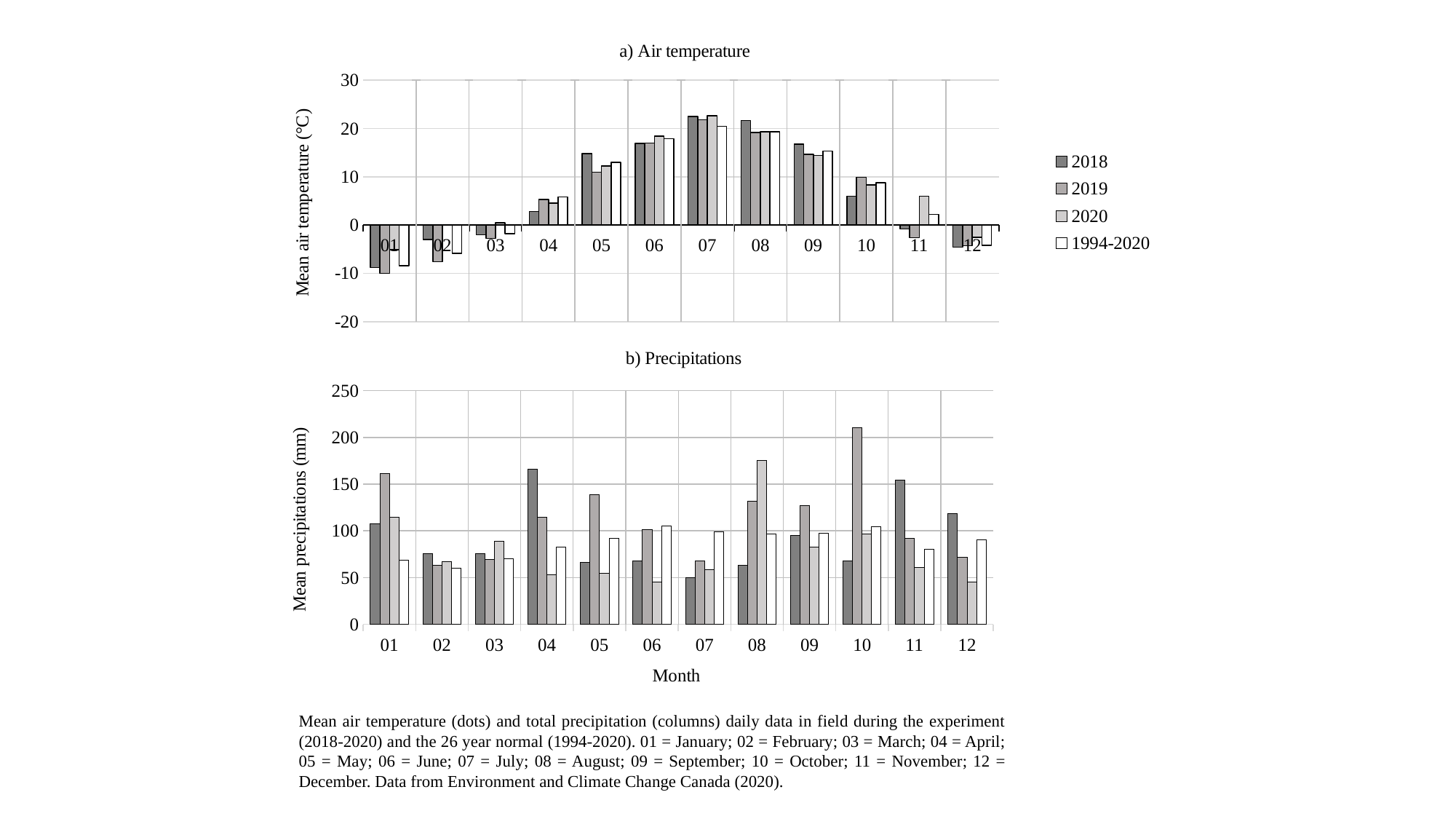
In the 'a) Air temperature' chart, which month has the lowest 2019 value? 01 How many series does the legend list? 4 In the 'b) Precipitations' chart, which is larger for 2020: month 07 or month 08? 08 In the 'a) Air temperature' chart, which month has the highest 1994-2020 value? 07 What is the y-axis label of the 'b) Precipitations' chart? Mean precipitations (mm) In the 'b) Precipitations' chart, is the 2019 value for month 10 greater or less than 200? greater In the 'a) Air temperature' chart, is the 2018 value for month 07 greater or less than 20? greater What kind of chart is the 'a) Air temperature' chart? bar chart In the 'b) Precipitations' chart, how many months are shown on the x axis? 12 In the 'a) Air temperature' chart, is the 2020 value for month 11 greater or less than 0? greater In the 'b) Precipitations' chart, which month has the highest 2019 value? 10 In the 'a) Air temperature' chart, do the 1994-2020 values rise or fall from month 01 to month 07? rise